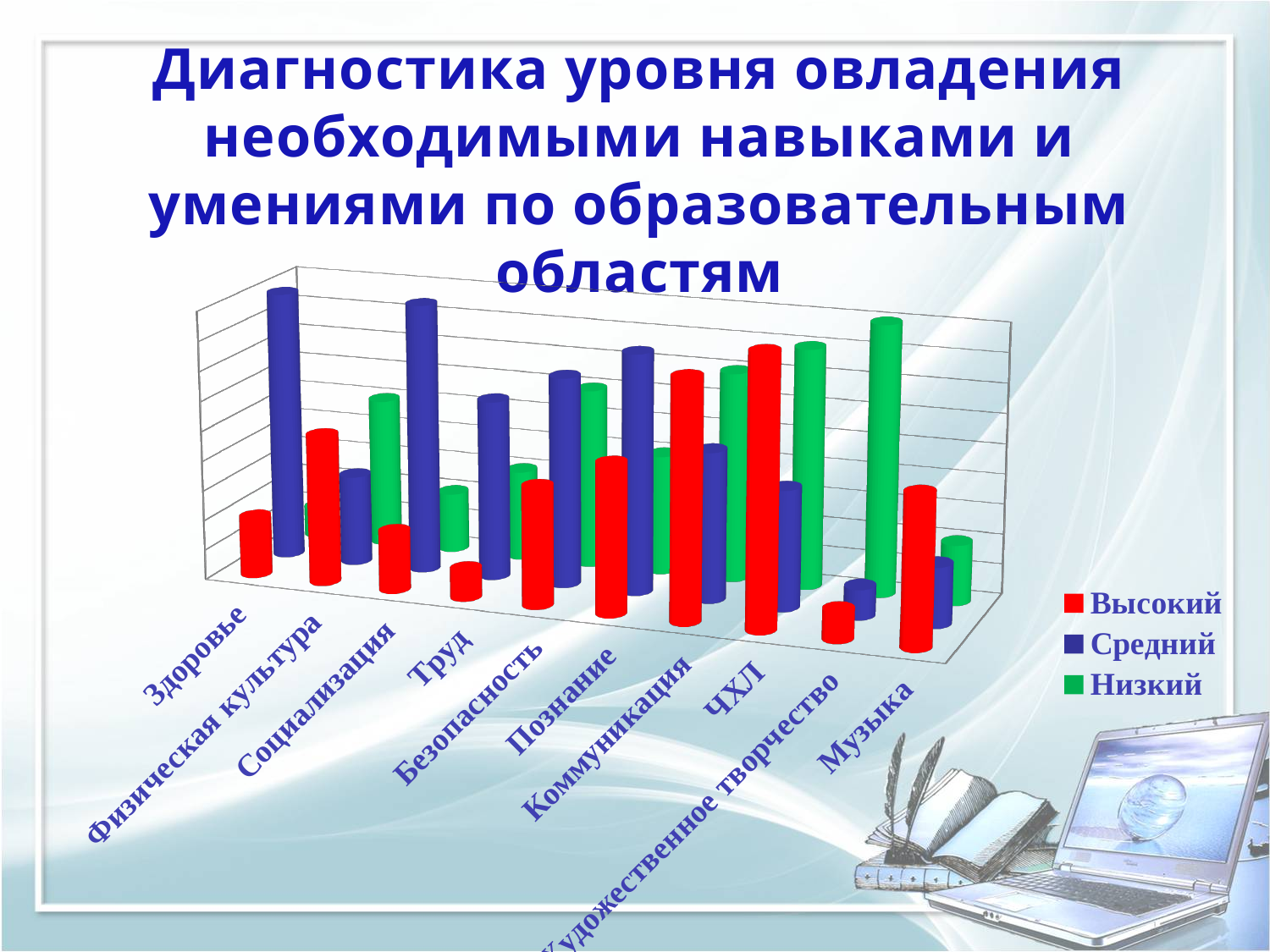
How many series does the chart's legend list? 3 What colour represents the Низкий series in the chart? Green For Здоровье, which is larger: the Высокий value or the Средний value? Средний For Художественное творчество, which is larger: the Низкий value or the Высокий value? Низкий Which category has the highest value for the Низкий series? Художественное творчество How many categories (educational areas) are shown on the x axis of the chart? 10 What are the three series listed in the chart's legend? Высокий, Средний, Низкий For Музыка, which is larger: the Высокий value or the Низкий value? Высокий What type of chart is shown on the slide? Bar chart Which category has the highest value for the Высокий series? ЧХЛ